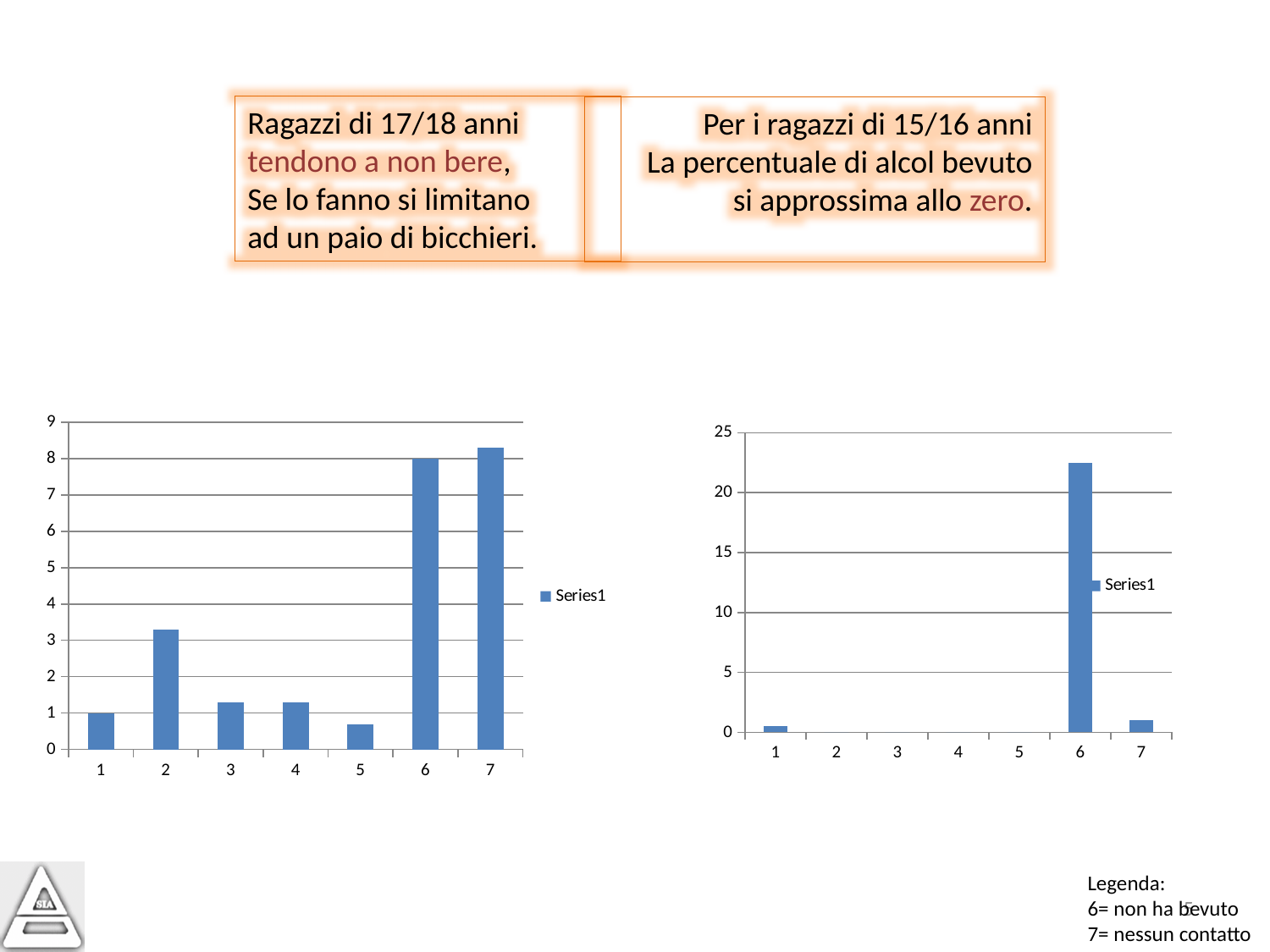
In the chart on the right, which is larger, the value for category 6 or the value for category 7? category 6 In the chart on the right, is the value for category 6 greater or less than 20? greater In the chart on the left, is the value for category 2 greater or less than 2? greater What is the legend entry shown next to the chart on the right? Series1 What kind of chart is the chart on the left of the slide? bar chart In the chart on the left, which category has the lowest value? 5 In the chart on the left, what is the value for category 1? 1 In the chart on the left, what is the value for category 6? 8 In the chart on the right, which category has the highest value? 6 How many categories are shown on the x axis of the chart on the right of the slide? 7 In the chart on the left, which is larger, the value for category 2 or the value for category 3? category 2 How many series does the legend of the chart on the left list? 1